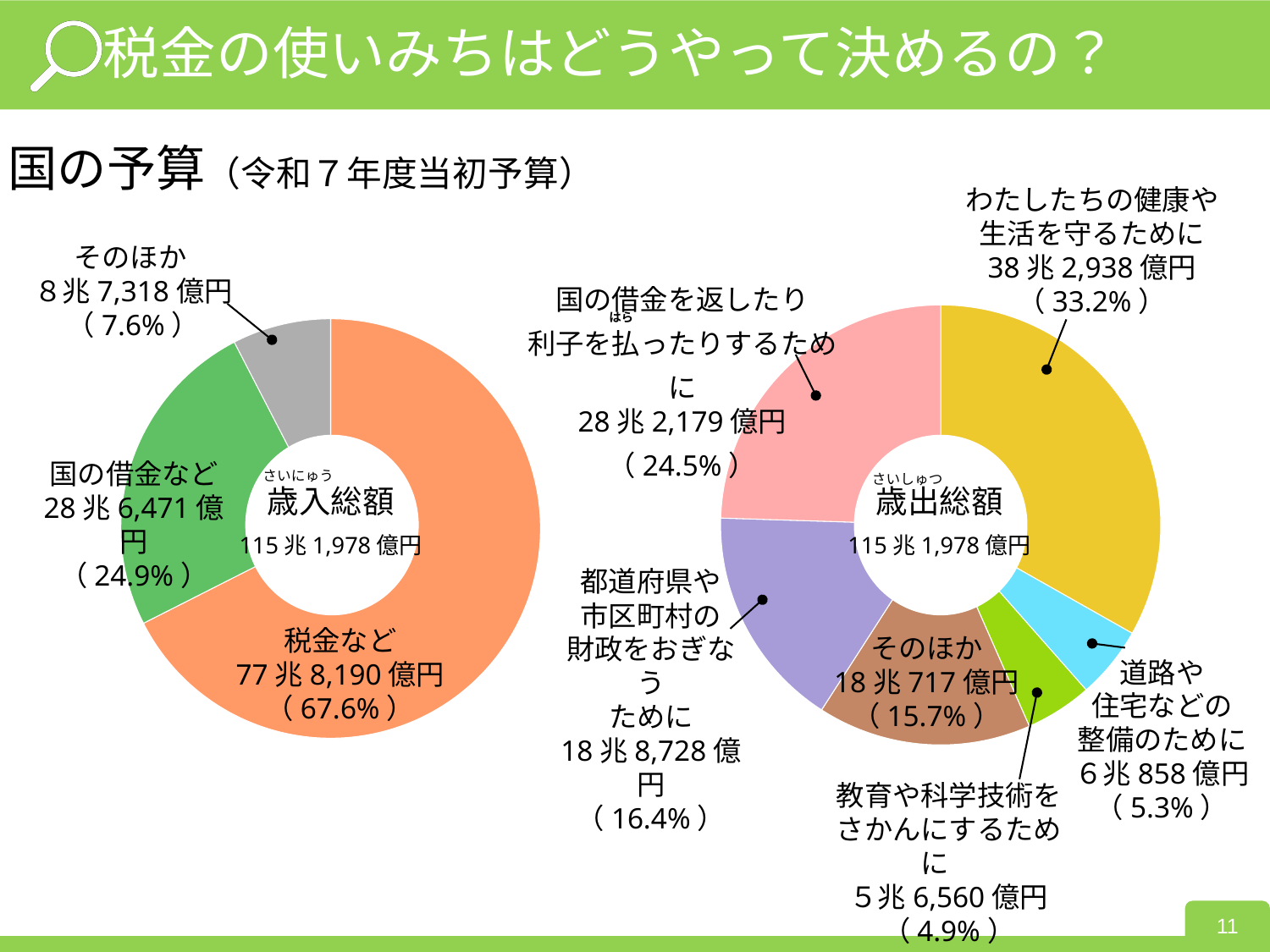
In the 歳出総額 chart on the right, what share of the total is 道路や住宅などの整備のために? 5.3% What kind of chart is the 歳出総額 chart on the right? Donut (pie) chart What total amount is shown in the centre of the 歳入総額 chart on the left? 115兆1,978億円 In the 歳出総額 chart on the right, how many categories are shown? 6 In the 歳入総額 chart on the left, which category is the smallest? そのほか In the 歳入総額 chart on the left, what is the value for 税金など? 77兆8,190億円 In the 歳出総額 chart on the right, which category is the smallest? 教育や科学技術をさかんにするために In the 歳入総額 chart on the left, what share of the total is 国の借金など? 24.9% In the 歳出総額 chart on the right, what is the value for わたしたちの健康や生活を守るために? 38兆2,938億円 In the 歳入総額 chart on the left, how many categories are shown? 3 In the 歳出総額 chart on the right, which category is the largest? わたしたちの健康や生活を守るために In the 歳出総額 chart on the right, which is larger: 都道府県や市区町村の財政をおぎなうために or そのほか? 都道府県や市区町村の財政をおぎなうために